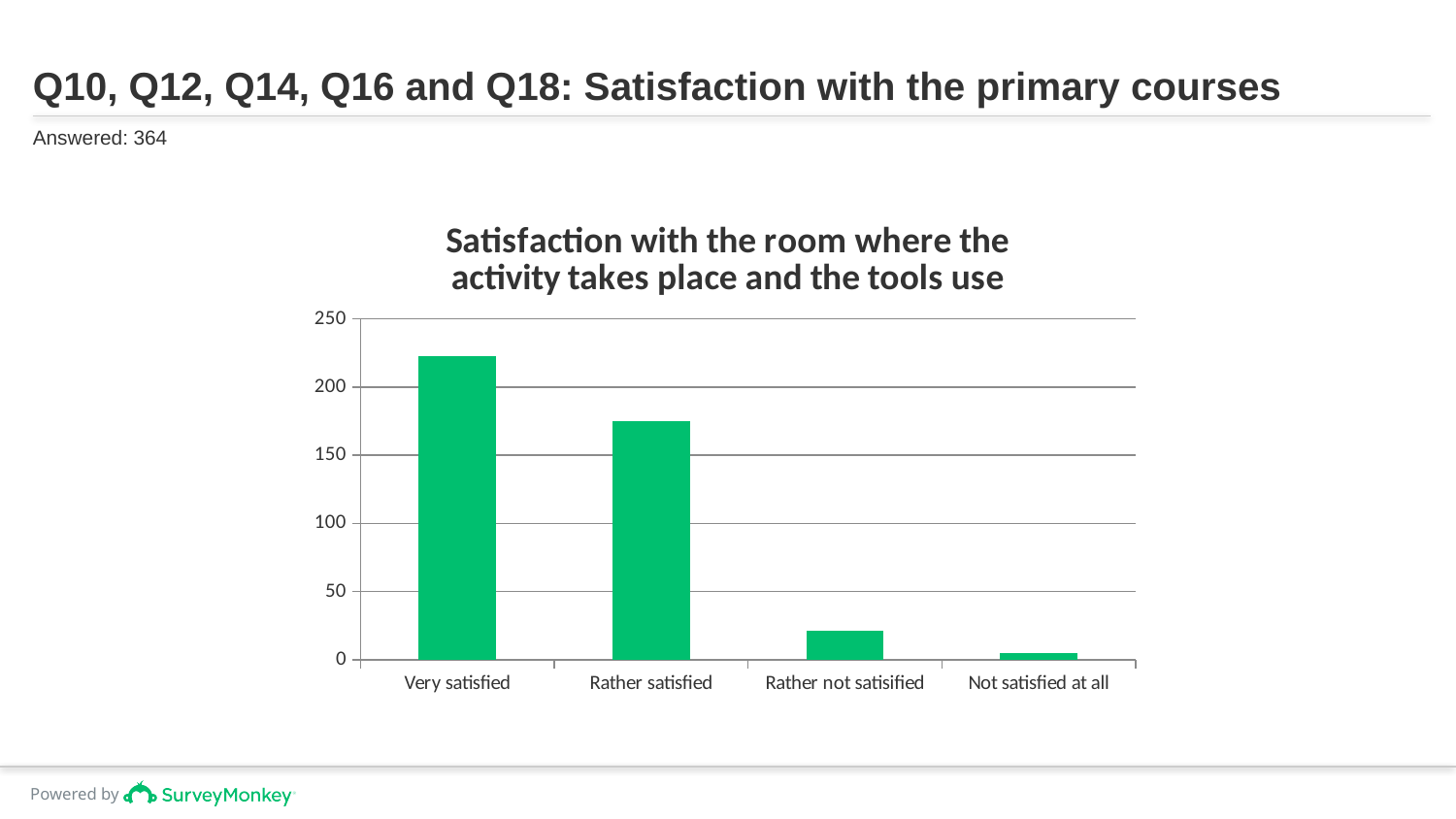
Which is larger, the value for Very satisfied or the value for Rather satisfied? Very satisfied Which category has the lowest value in the chart? Not satisfied at all Is the value for Very satisfied greater or less than 200? greater What kind of chart is shown on the slide? bar chart Is the value for Rather satisfied greater or less than 200? less Do the values rise or fall from left to right along the x axis? fall Is the value for Not satisfied at all greater or less than 50? less What is the title of the chart? Satisfaction with the room where the activity takes place and the tools use Which category has the highest value in the chart? Very satisfied How many categories are shown on the x axis of the chart? 4